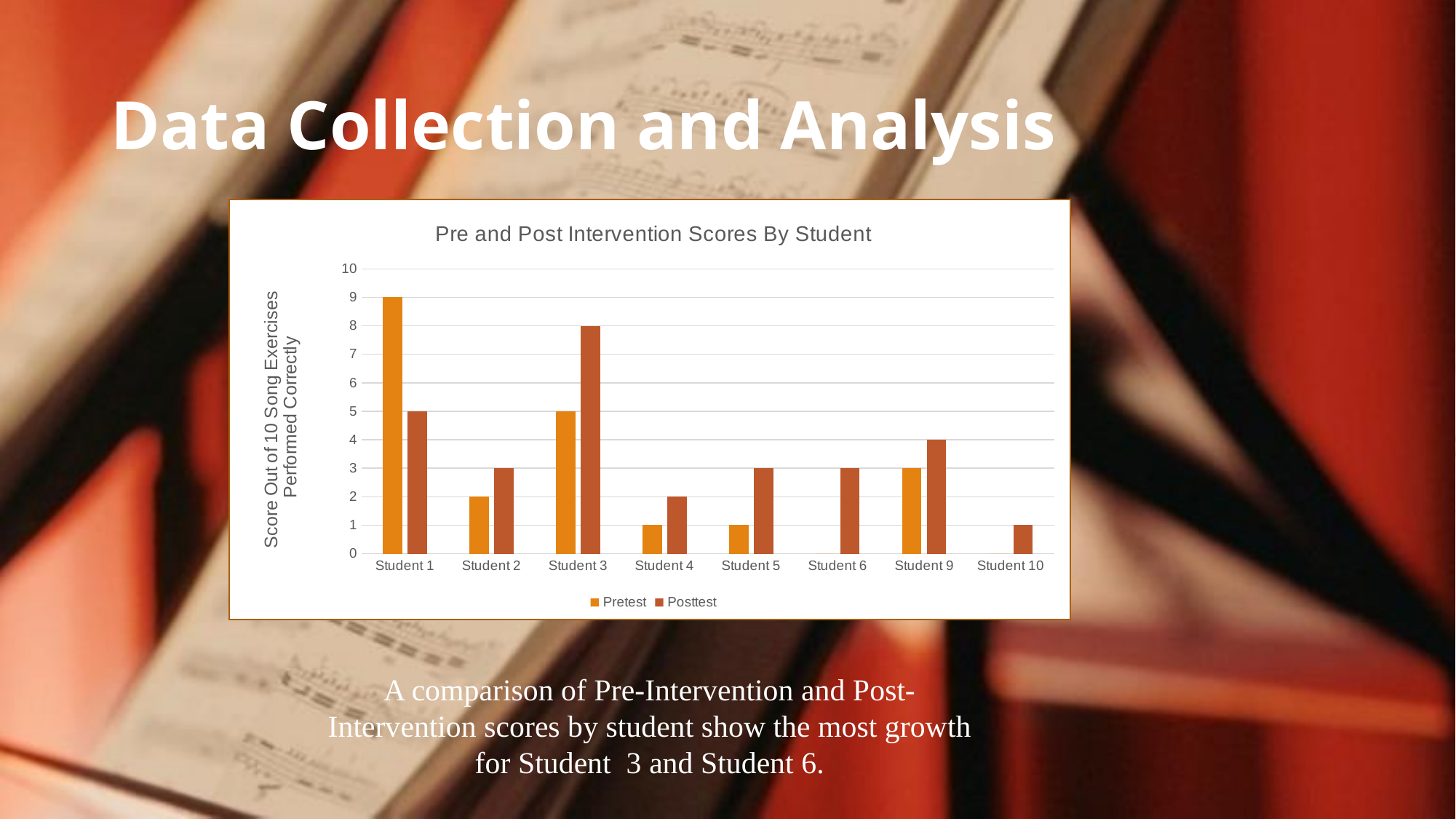
What is the Posttest score for Student 6? 3 How many series does the legend list? 2 What is the Pretest score for Student 1? 9 What is the Posttest score for Student 3? 8 Which is larger for Student 1, the Pretest score or the Posttest score? Pretest What type of chart is shown on the slide? bar chart What is the title of the chart? Pre and Post Intervention Scores By Student Which student has the lowest Posttest score? Student 10 Is the Posttest score for Student 9 greater or less than 3? greater What is the difference between the Posttest and Pretest scores for Student 3? 3 Which student has the highest Pretest score? Student 1 How many students are shown on the x axis? 8